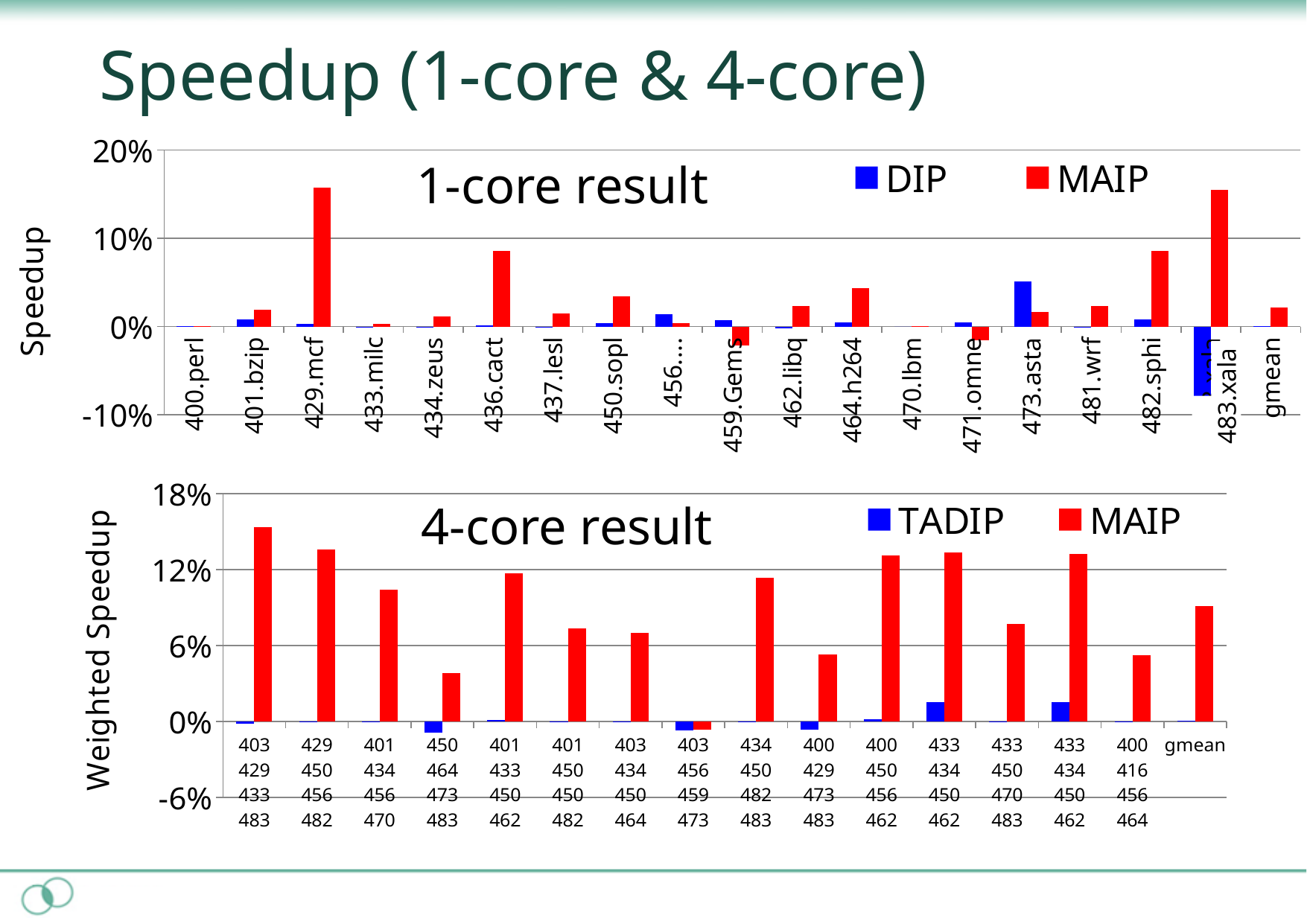
How many categories are shown on the x axis of the 1-core result chart? 19 What kind of chart is the 1-core result chart? bar chart Which series are listed in the legend of the 4-core result chart? TADIP and MAIP How many categories are shown on the x axis of the 4-core result chart? 16 In the 4-core result chart, which workload mix has the highest MAIP value? 403/429/433/483 In the 1-core result chart, is the MAIP value for 436.cact greater or less than 10%? less In the 1-core result chart, which is larger, the MAIP value for 429.mcf or for 436.cact? 429.mcf In the 1-core result chart, which category has the highest DIP value? 473.asta How many series does the legend of the 1-core result chart list? 2 In the 4-core result chart, is the MAIP value for gmean greater or less than 6%? greater In the 1-core result chart, is the MAIP value for 429.mcf greater or less than 10%? greater In the 1-core result chart, which category has the lowest DIP value? 483.xala